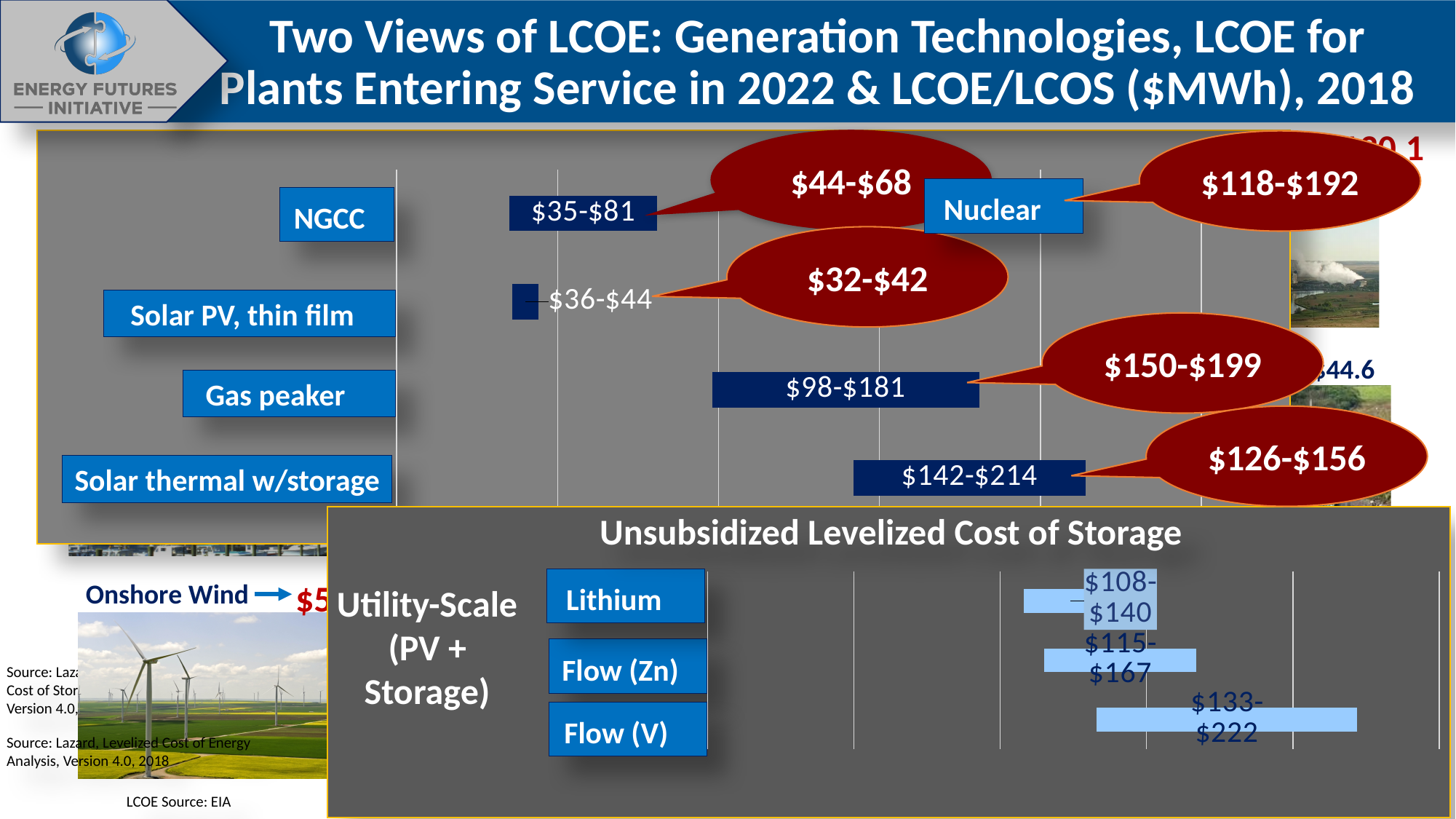
In the Unsubsidized Levelized Cost of Storage chart, what range is labeled for Lithium? $108-$140 In the Unsubsidized Levelized Cost of Storage chart, what range is labeled for Flow (V)? $133-$222 In the Unsubsidized Levelized Cost of Storage chart, which storage technology has the lowest lower end of its cost range? Lithium How many storage technologies are plotted in the Unsubsidized Levelized Cost of Storage chart? 3 In the top chart, what LCOE range is labeled on the bar for NGCC? $35-$81 In the Unsubsidized Levelized Cost of Storage chart, which storage technology has the highest upper end of its cost range? Flow (V) What kind of chart is the Unsubsidized Levelized Cost of Storage chart? Bar chart In the Unsubsidized Levelized Cost of Storage chart, what range is labeled for Flow (Zn)? $115-$167 In the top chart, what LCOE range is labeled on the bar for Gas peaker? $98-$181 In the top chart, what LCOE range is labeled on the bar for Solar PV, thin film? $36-$44 In the top chart, what LCOE range is labeled on the bar for Solar thermal w/storage? $142-$214 In the top chart, which has the higher upper end of its labeled range: Gas peaker or Solar thermal w/storage? Solar thermal w/storage